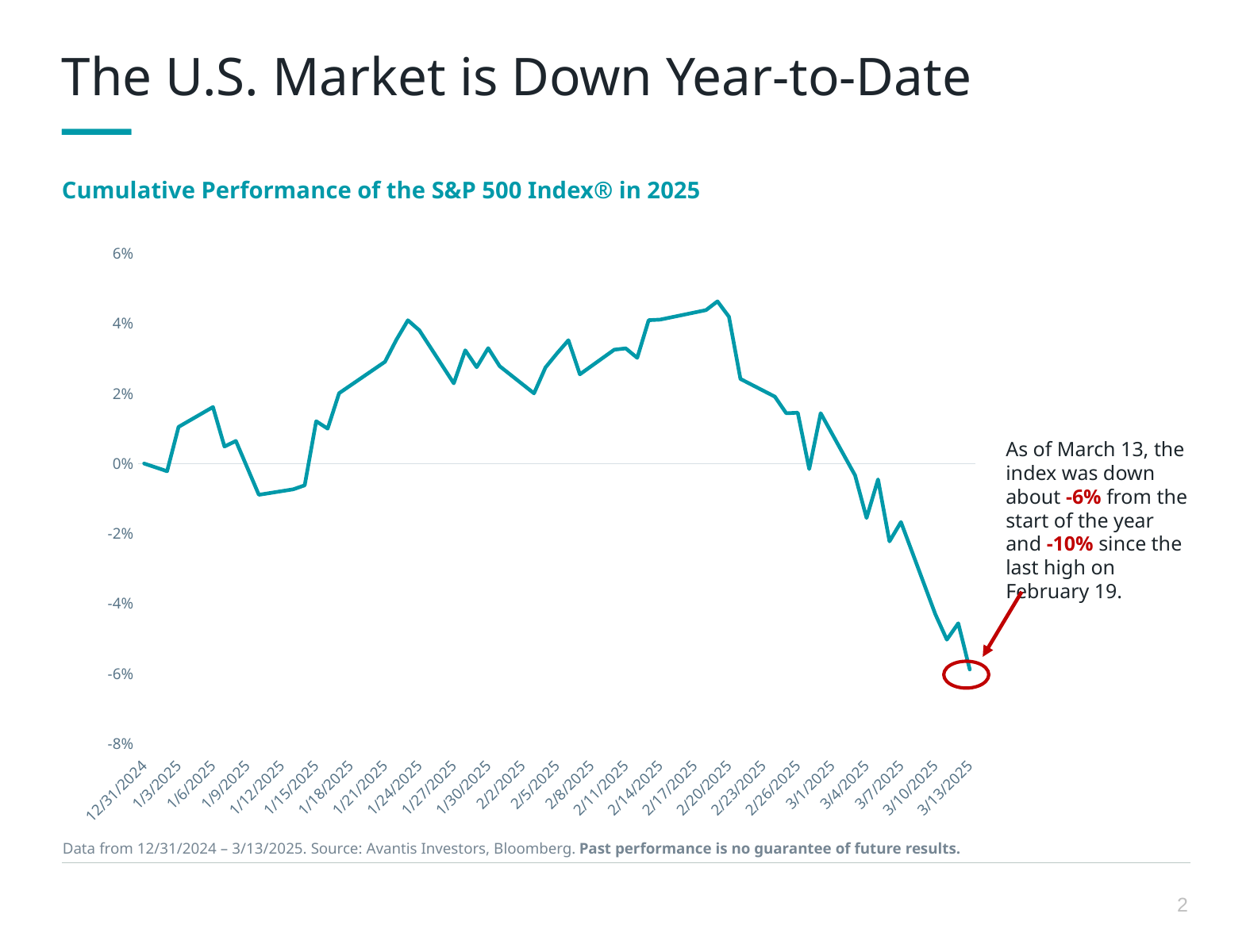
What is the title of the chart? Cumulative Performance of the S&P 500 Index® in 2025 Is the value for 3/10/2025 greater or less than -2%? less Does the line rise or fall between 2/20/2025 and 3/13/2025? fall Is the value for 1/12/2025 greater or less than 0%? less Is the value for 1/24/2025 greater or less than 2%? greater On which date does the line reach its lowest point? 3/13/2025 What type of chart is shown on the slide? line chart Which is higher, the value for 1/3/2025 or the value for 3/13/2025? 1/3/2025 According to the annotation, how much was the index down since the last high on February 19? -10%